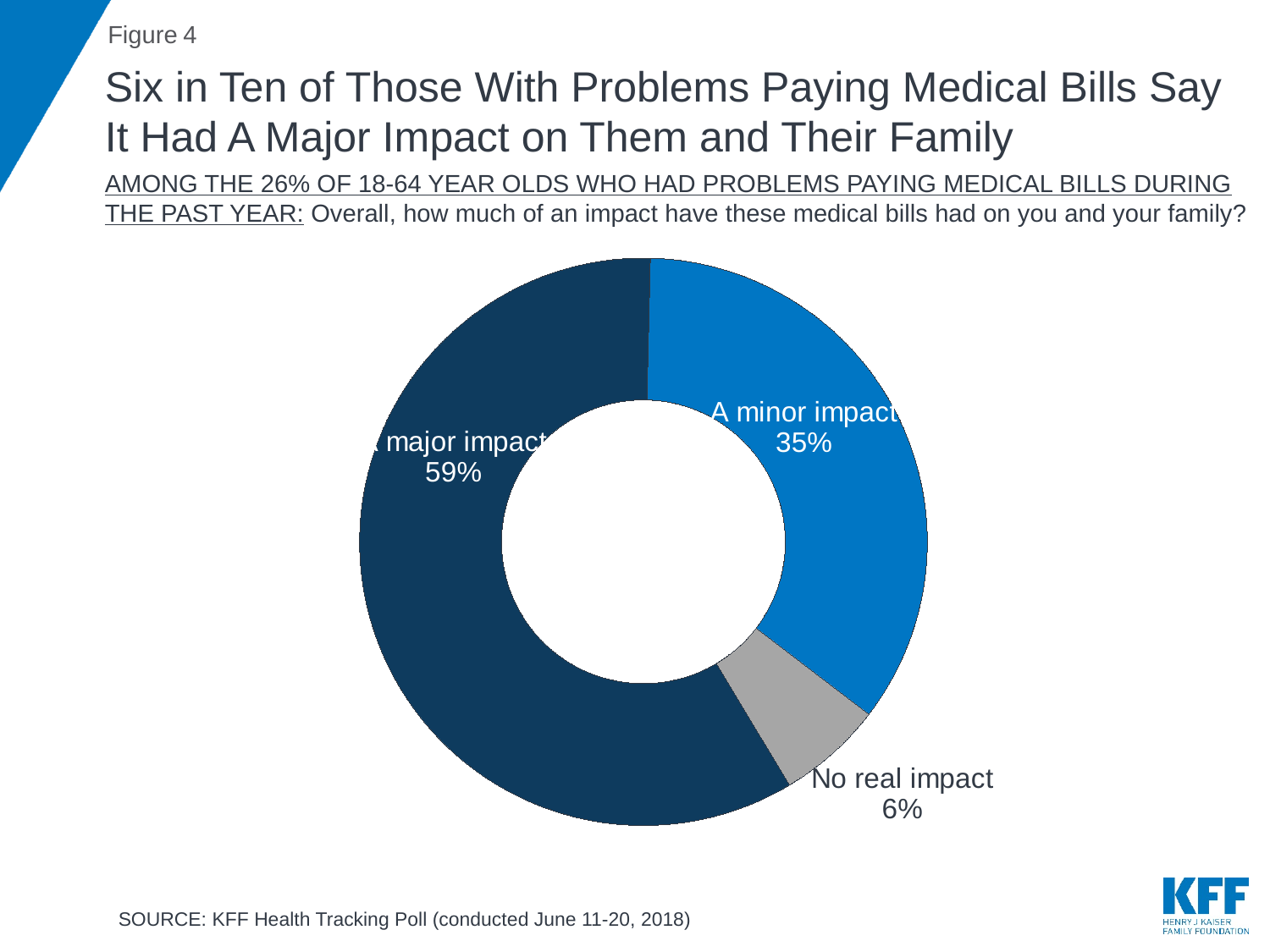
What is the difference in percentage points between 'A major impact' and 'A minor impact'? 24 What percentage of respondents said the medical bills had a minor impact? 35% Which response category has the largest share of the pie? A major impact What percentage of respondents said the medical bills had a major impact? 59% What kind of chart is shown on the slide? Pie chart (doughnut) Which response category has the smallest share of the pie? No real impact What percentage of respondents said the medical bills had no real impact? 6% What is the source cited at the bottom of the slide? KFF Health Tracking Poll (conducted June 11-20, 2018) Which is larger: the share for 'A minor impact' or the share for 'No real impact'? A minor impact What is the combined share of 'A major impact' and 'A minor impact'? 94% How many response categories are shown in the chart? 3 What is the difference in percentage points between 'A minor impact' and 'No real impact'? 29